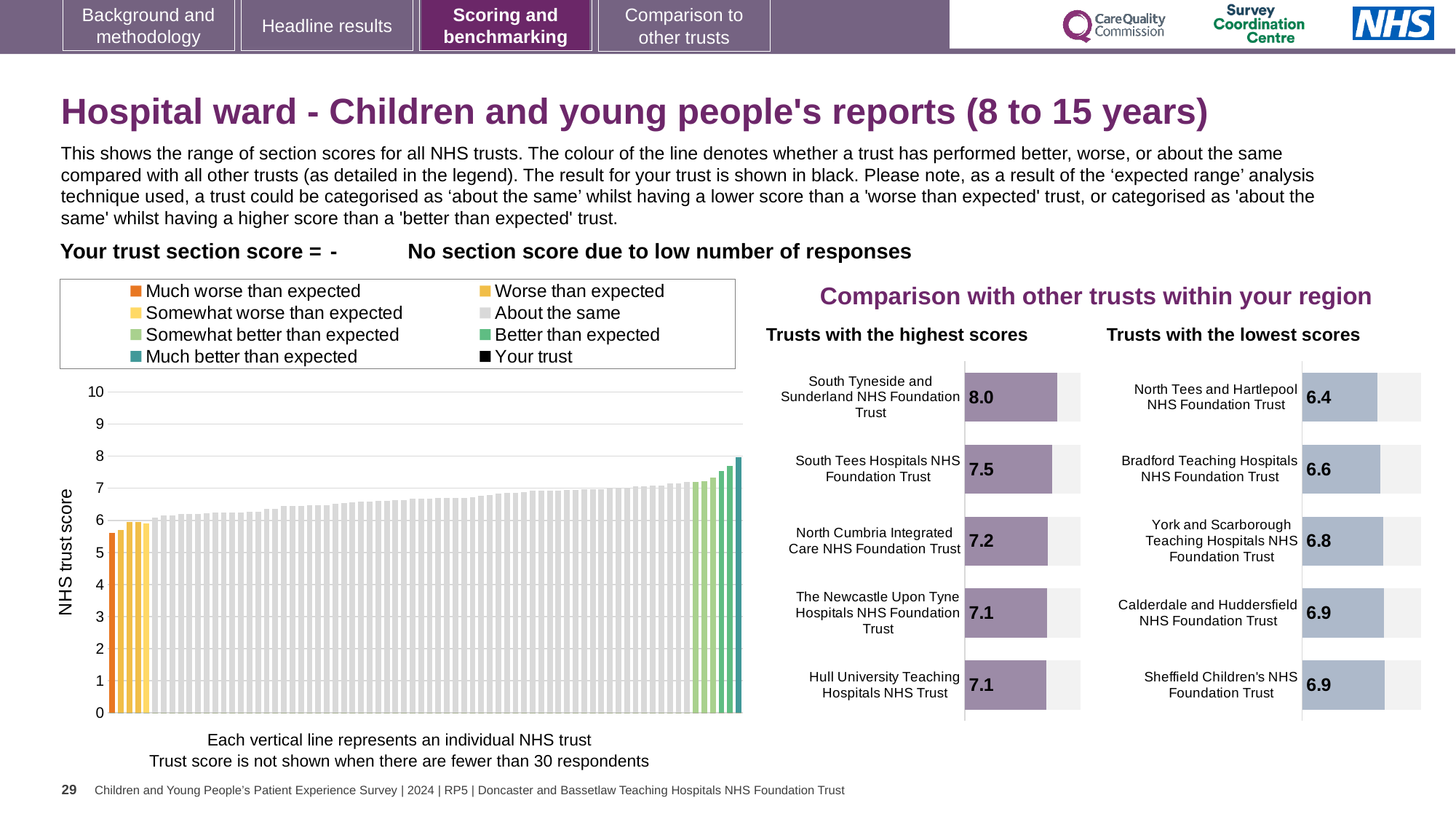
In the 'Trusts with the lowest scores' chart, what is the score for Bradford Teaching Hospitals NHS Foundation Trust? 6.6 What kind of chart is the large 'NHS trust score' chart on the left of the slide? Bar chart How many trusts are listed in the 'Trusts with the lowest scores' chart? 5 In the 'Trusts with the highest scores' chart, what is the score for South Tyneside and Sunderland NHS Foundation Trust? 8.0 In the 'Trusts with the lowest scores' chart, what is the difference between the scores of Sheffield Children's NHS Foundation Trust and North Tees and Hartlepool NHS Foundation Trust? 0.5 In the 'Trusts with the highest scores' chart, what is the score for North Cumbria Integrated Care NHS Foundation Trust? 7.2 How many entries does the legend above the large 'NHS trust score' chart list? 8 In the 'Trusts with the highest scores' chart, which has the higher score: South Tees Hospitals NHS Foundation Trust or North Cumbria Integrated Care NHS Foundation Trust? South Tees Hospitals NHS Foundation Trust In the large 'NHS trust score' chart on the left, do the bar values rise or fall from left to right? Rise In the 'Trusts with the highest scores' chart, what is the difference between the scores of South Tyneside and Sunderland NHS Foundation Trust and South Tees Hospitals NHS Foundation Trust? 0.5 In the 'Trusts with the lowest scores' chart, which trust has the lowest score? North Tees and Hartlepool NHS Foundation Trust In the 'Trusts with the highest scores' chart, which trust has the highest score? South Tyneside and Sunderland NHS Foundation Trust